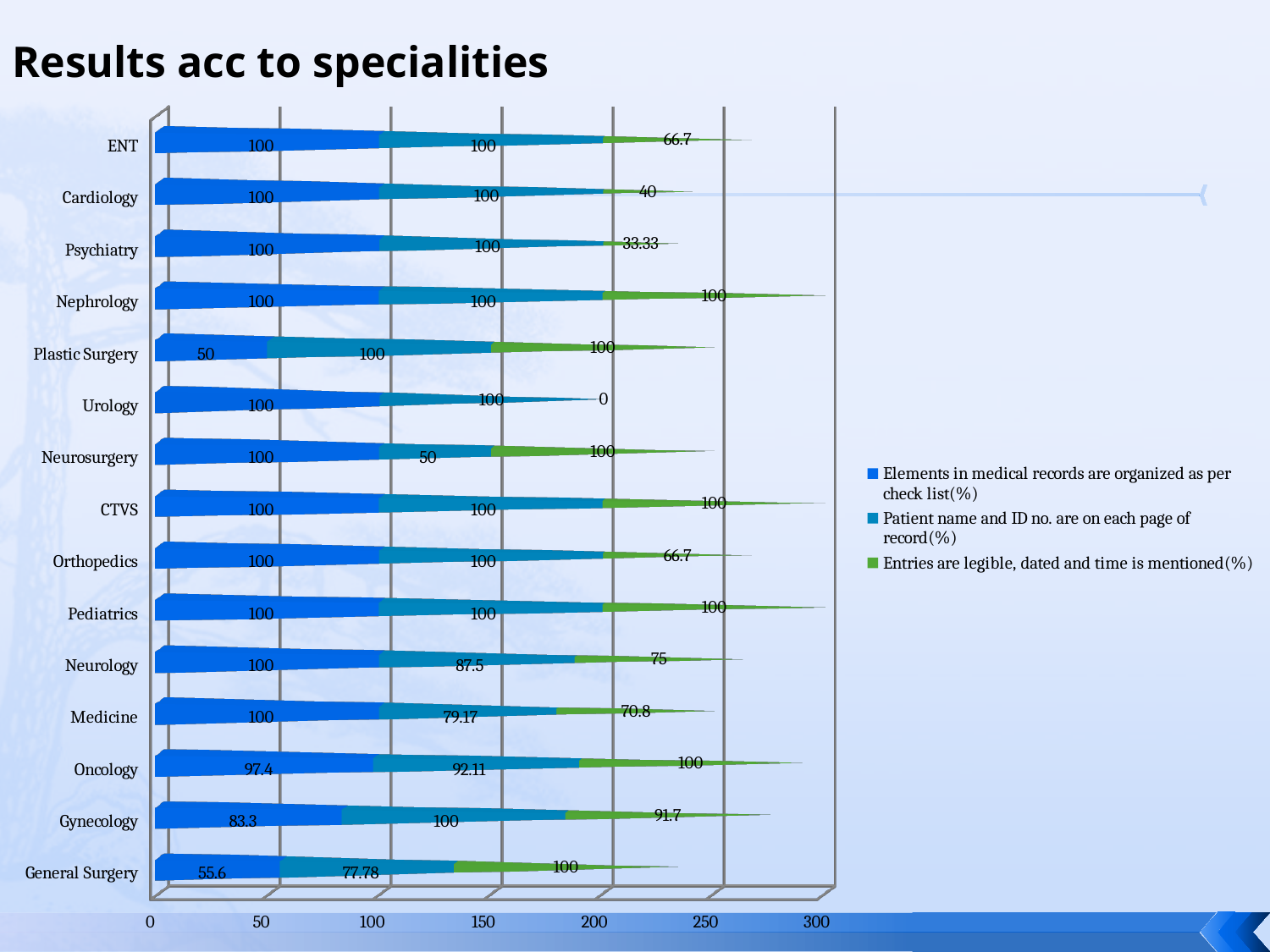
What is the total of the stacked bar for General Surgery? 233.38 Which is larger: the 'Entries are legible, dated and time is mentioned(%)' value for Neurology or for Medicine? Neurology What is the value for Cardiology in the 'Entries are legible, dated and time is mentioned(%)' series? 40 Which speciality has the lowest value in the 'Entries are legible, dated and time is mentioned(%)' series? Urology Which speciality has the lowest value in the 'Elements in medical records are organized as per check list(%)' series? Plastic Surgery What is the difference between the 'Entries are legible, dated and time is mentioned(%)' values for ENT and Psychiatry? 33.37 How many specialities are shown on the chart? 15 What is the value for General Surgery in the 'Elements in medical records are organized as per check list(%)' series? 55.6 What kind of chart is shown on the slide? Stacked bar chart How many series does the legend list? 3 Which speciality has the lowest value in the 'Patient name and ID no. are on each page of record(%)' series? Neurosurgery What is the value for Medicine in the 'Patient name and ID no. are on each page of record(%)' series? 79.17